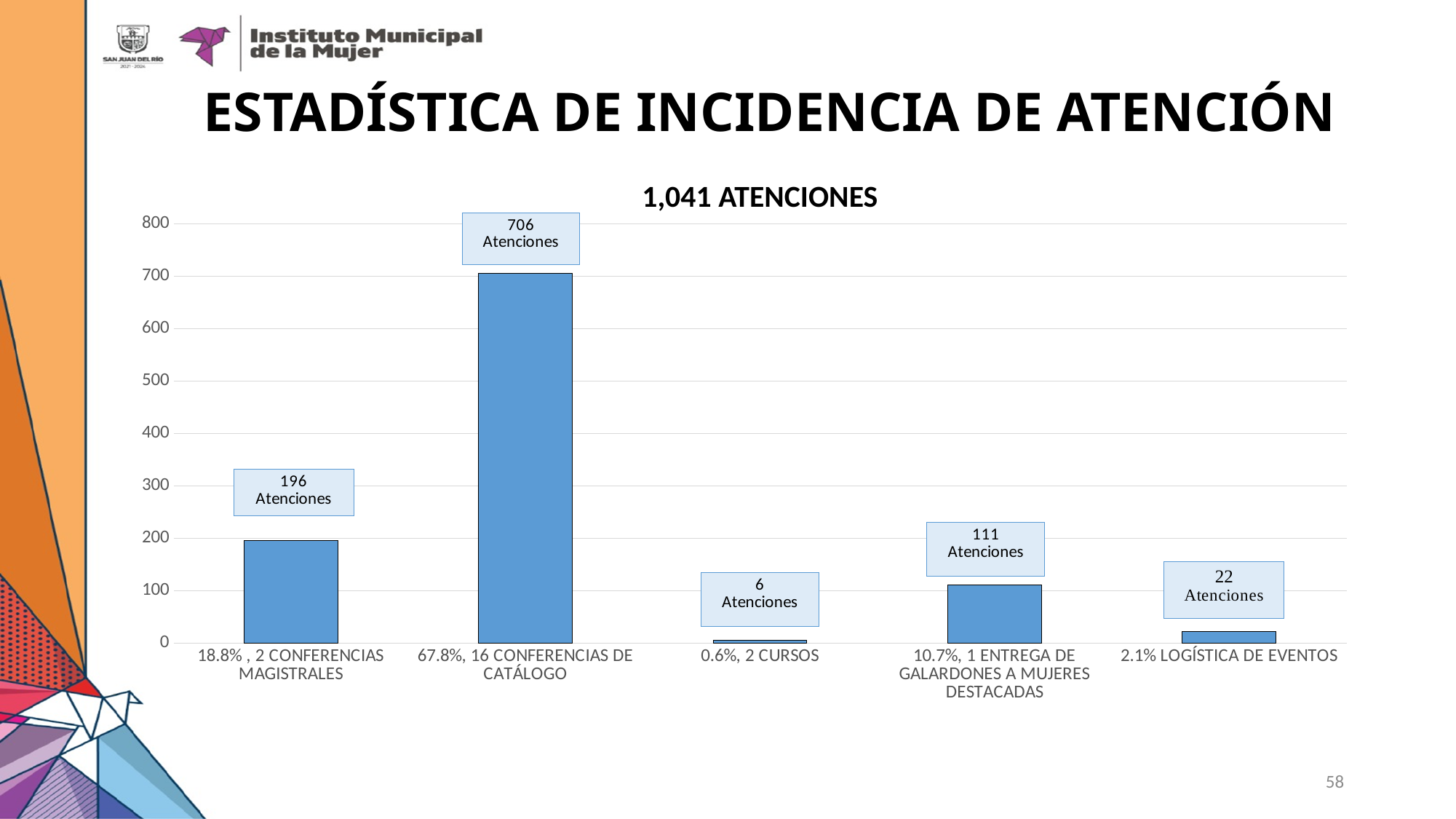
How many atenciones are shown for the category '67.8%, 16 CONFERENCIAS DE CATÁLOGO'? 706 How many categories are shown on the x axis of the chart? 5 What is the value for '18.8% , 2 CONFERENCIAS MAGISTRALES'? 196 Is the value for '2 CONFERENCIAS MAGISTRALES' greater or less than 100? greater What is the value for '2.1% LOGÍSTICA DE EVENTOS'? 22 What is the title of the chart? 1,041 ATENCIONES Which category has the highest number of atenciones? 67.8%, 16 CONFERENCIAS DE CATÁLOGO Which has more atenciones: '1 ENTREGA DE GALARDONES A MUJERES DESTACADAS' or 'LOGÍSTICA DE EVENTOS'? 1 ENTREGA DE GALARDONES A MUJERES DESTACADAS What is the difference in atenciones between '16 CONFERENCIAS DE CATÁLOGO' and '2 CONFERENCIAS MAGISTRALES'? 510 How many atenciones does the '0.6%, 2 CURSOS' bar show? 6 Which category has the lowest number of atenciones? 0.6%, 2 CURSOS What kind of chart is shown on the slide? bar chart